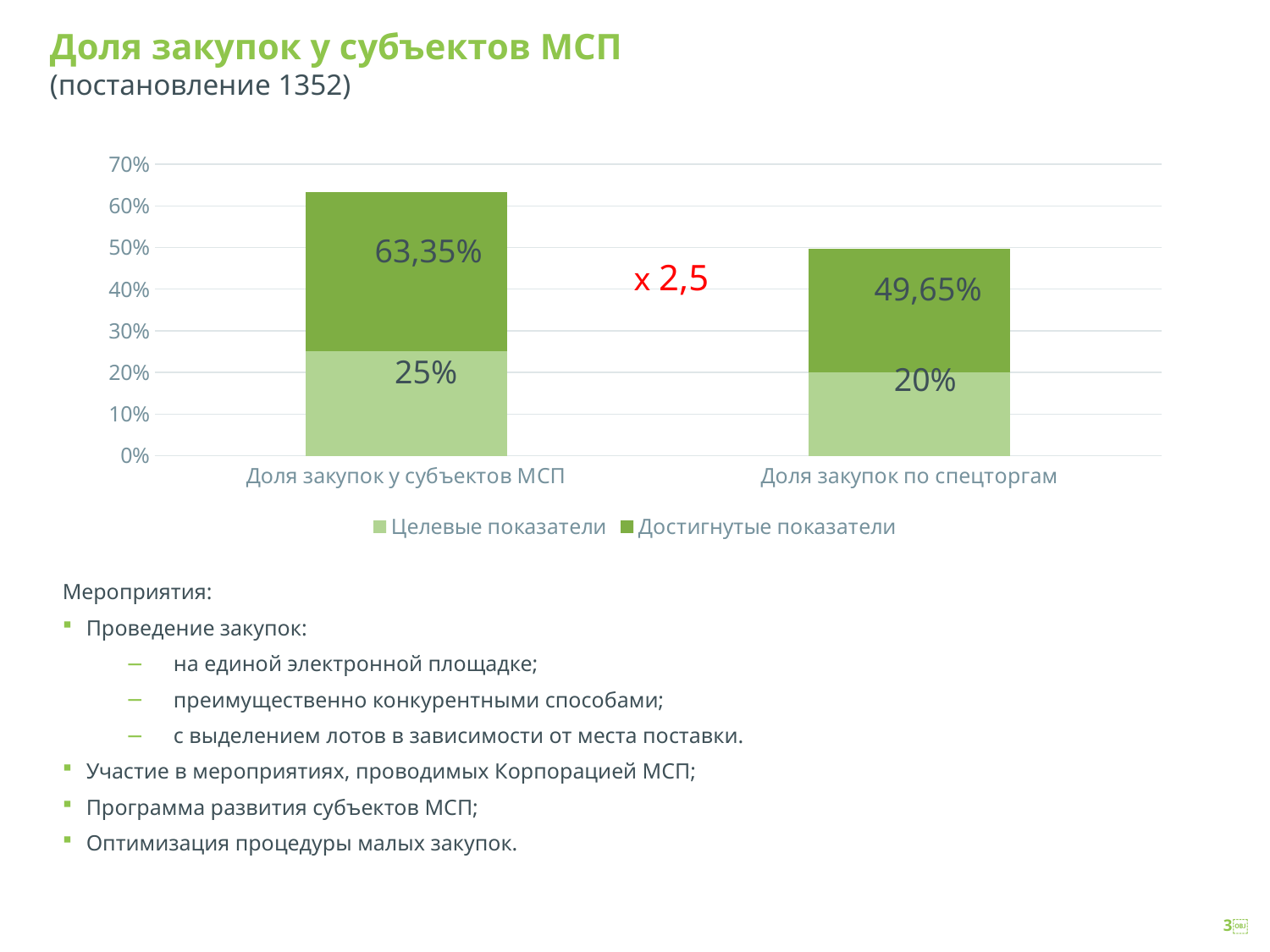
Which category has the higher Достигнутые показатели value? Доля закупок у субъектов МСП What is the value of Достигнутые показатели for Доля закупок по спецторгам? 49,65% Which category has the lowest Целевые показатели value? Доля закупок по спецторгам By how much does the Достигнутые показатели value exceed the Целевые показатели value for Доля закупок у субъектов МСП? 38,35% What is the value of Целевые показатели for Доля закупок по спецторгам? 20% What is the value of Достигнутые показатели for Доля закупок у субъектов МСП? 63,35% How many categories are shown on the x axis of the chart? 2 What red annotation is written between the two bars of the chart? x 2,5 How many series does the chart legend list? 2 What kind of chart is shown on the slide? Bar chart By how much does the Достигнутые показатели value exceed the Целевые показатели value for Доля закупок по спецторгам? 29,65% What is the value of Целевые показатели for Доля закупок у субъектов МСП? 25%